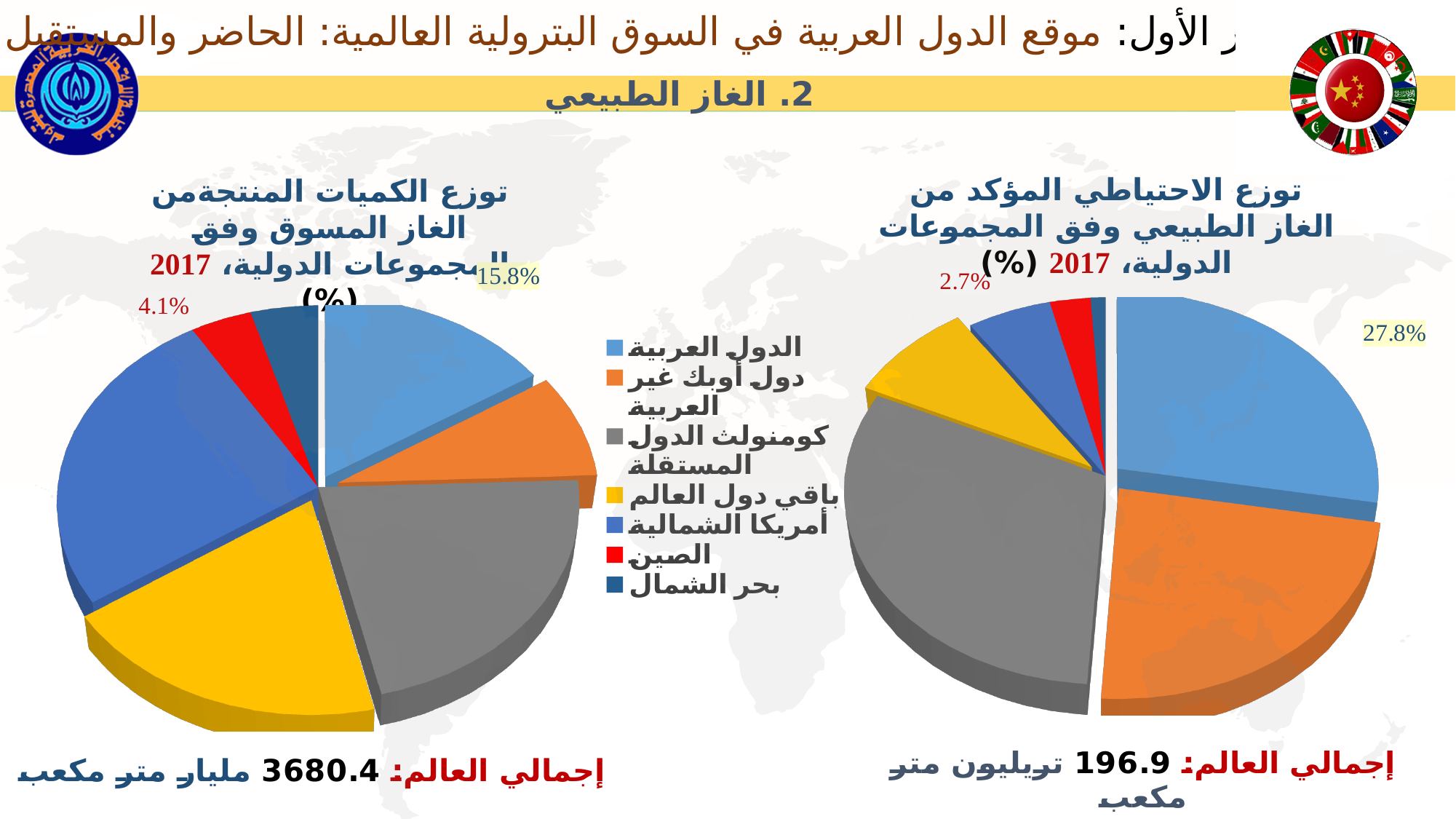
Is the share of الدول العربية larger in the left chart (production) or the right chart (reserves)? the right chart (reserves) What type of chart is used on this slide? pie chart By how many percentage points does the share of الصين in the left chart (production) exceed its share in the right chart (reserves)? 1.4 percentage points In the right chart (توزع الاحتياطي المؤكد من الغاز الطبيعي), what percentage is labelled for الدول العربية? 27.8% What world total is stated below the right chart (proven reserves)? 196.9 تريليون متر مكعب In the right chart (proven reserves), which group has the smallest slice? بحر الشمال By how many percentage points does the share of الدول العربية in the right chart (reserves) exceed its share in the left chart (production)? 12 percentage points What world total is stated below the left chart (marketed production)? 3680.4 مليار متر مكعب How many groups does the legend list? 7 In the left chart (marketed production), what percentage is labelled for الصين? 4.1% In the right chart (proven reserves), what percentage is labelled for الصين? 2.7% In the left chart (توزع الكميات المنتجة من الغاز المسوق), what percentage is labelled for الدول العربية? 15.8%